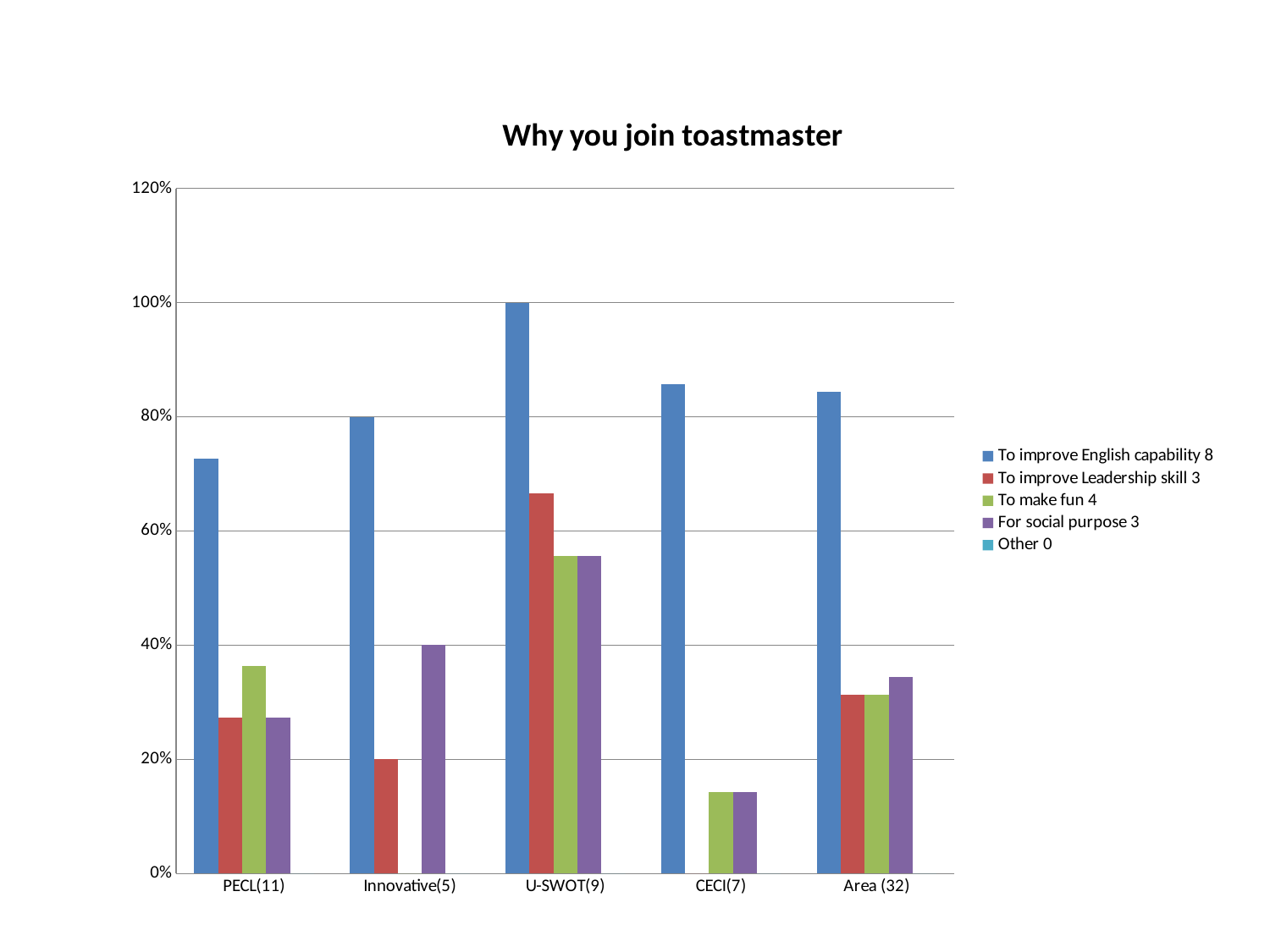
What kind of chart is shown on the slide? bar chart How many categories are shown on the x axis? 5 How many series does the legend list? 5 What is the title of the chart? Why you join toastmaster Is the value for 'To make fun' in the PECL(11) category greater or less than 40%? less What is the value for 'For social purpose' in the Innovative(5) category? 40% Is the value for 'To improve English capability' in the CECI(7) category greater or less than 80%? greater What is the value for 'To improve Leadership skill' in the Innovative(5) category? 20% What is the value for 'To improve English capability' in the U-SWOT(9) category? 100% In the U-SWOT(9) category, which is larger: 'To improve Leadership skill' or 'To make fun'? To improve Leadership skill Which category has the highest value for 'To improve English capability'? U-SWOT(9) What is the value for 'To improve English capability' in the Innovative(5) category? 80%